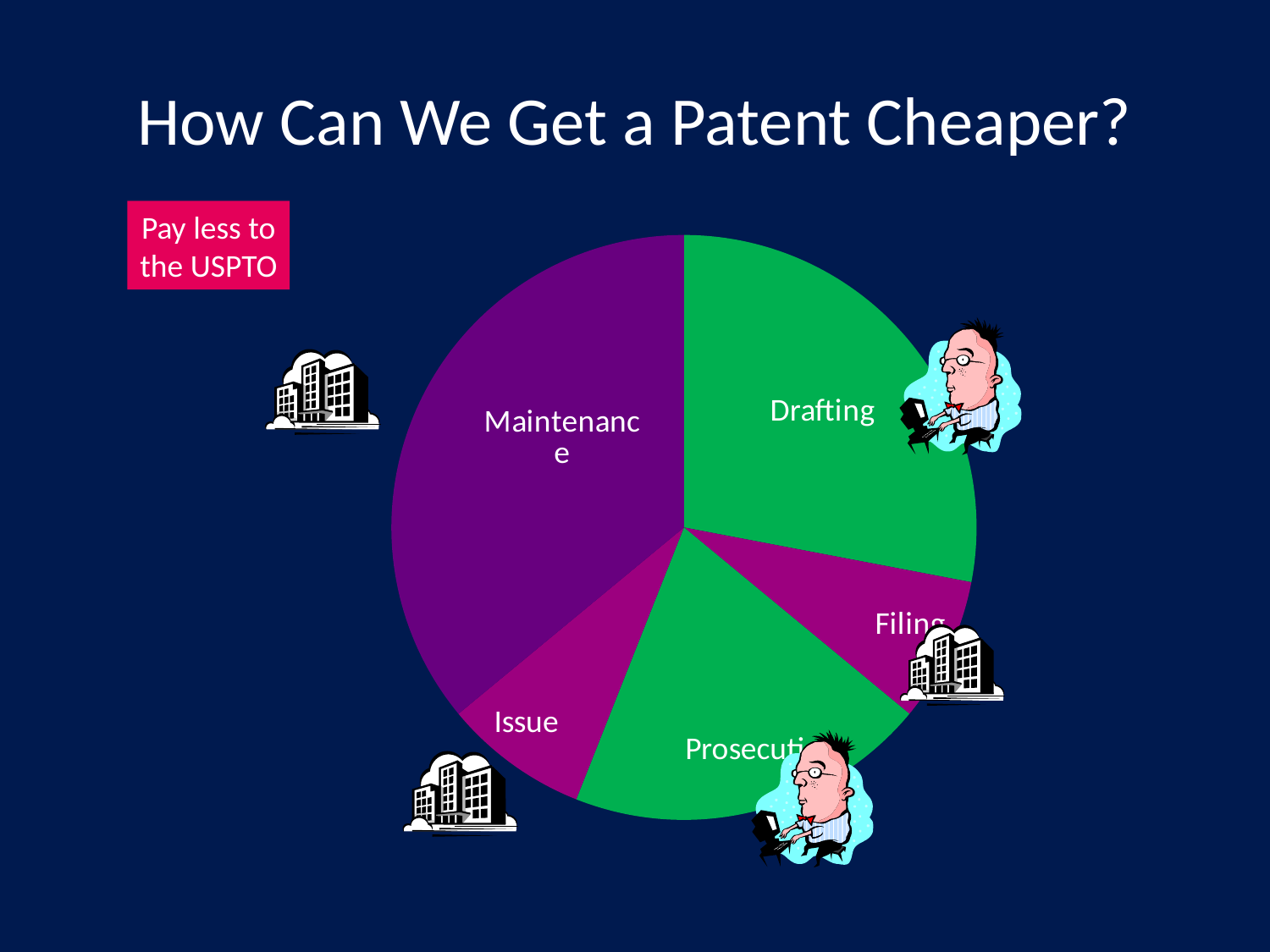
Which slice is larger, Prosecution or Issue? Prosecution Which slice of the pie chart is the largest? Maintenance Which slice is larger, Maintenance or Issue? Maintenance What kind of chart is shown on the slide? pie chart Which slice is larger, Drafting or Filing? Drafting What is the title of the slide containing the pie chart? How Can We Get a Patent Cheaper? What colour is the Drafting slice of the pie chart? green How many slices does the pie chart have? 5